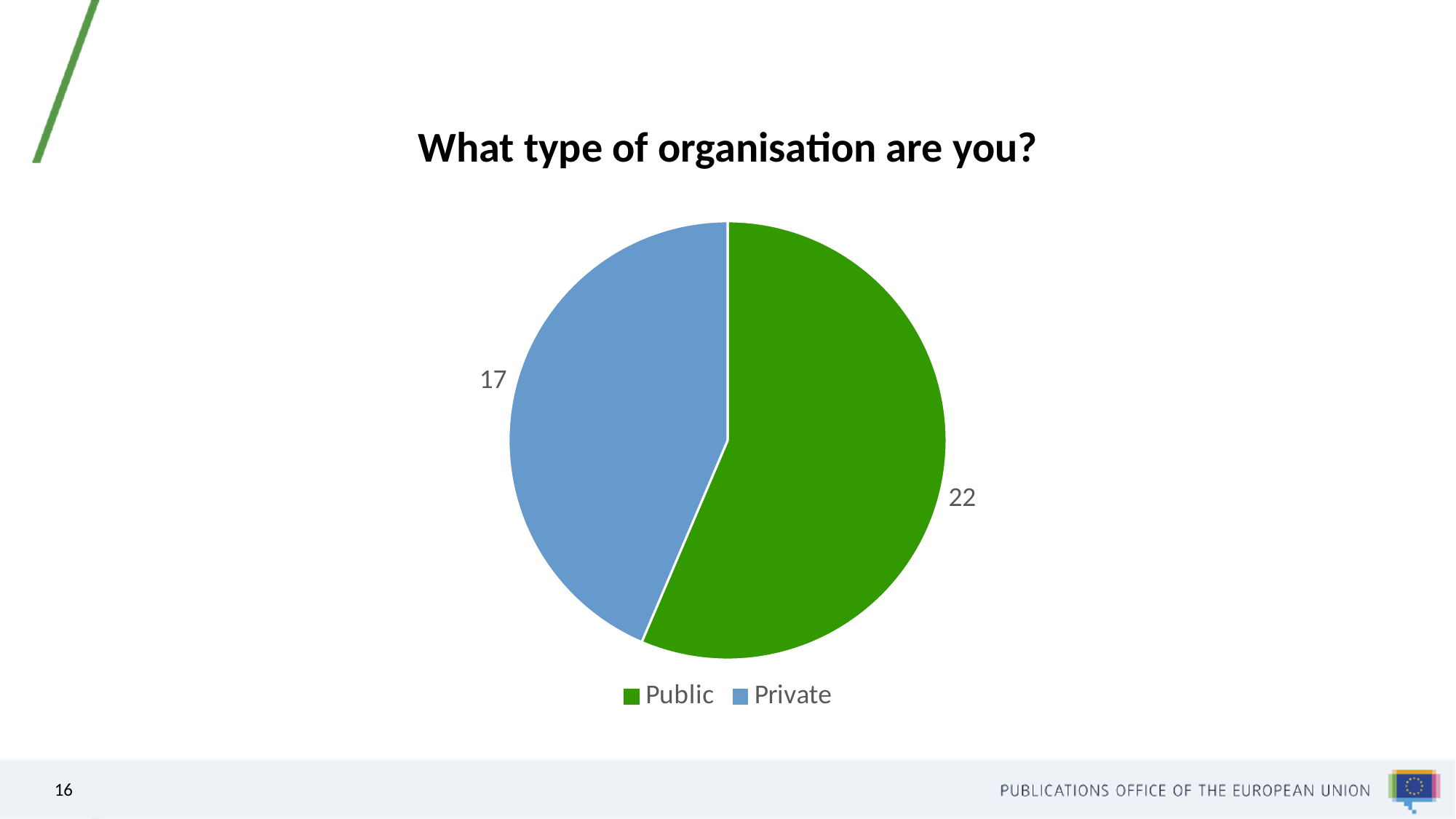
What is the total of all slices in the pie chart? 39 Which category has the smallest slice? Private What is the difference between the Public and Private values? 5 What is the value for Private? 17 Which category has the largest slice? Public What colour is the Private slice? Blue What is the value for Public? 22 What kind of chart is shown on the slide? Pie chart Which is larger, Public or Private? Public What is the title of the chart? What type of organisation are you? How many slices does the pie chart have? 2